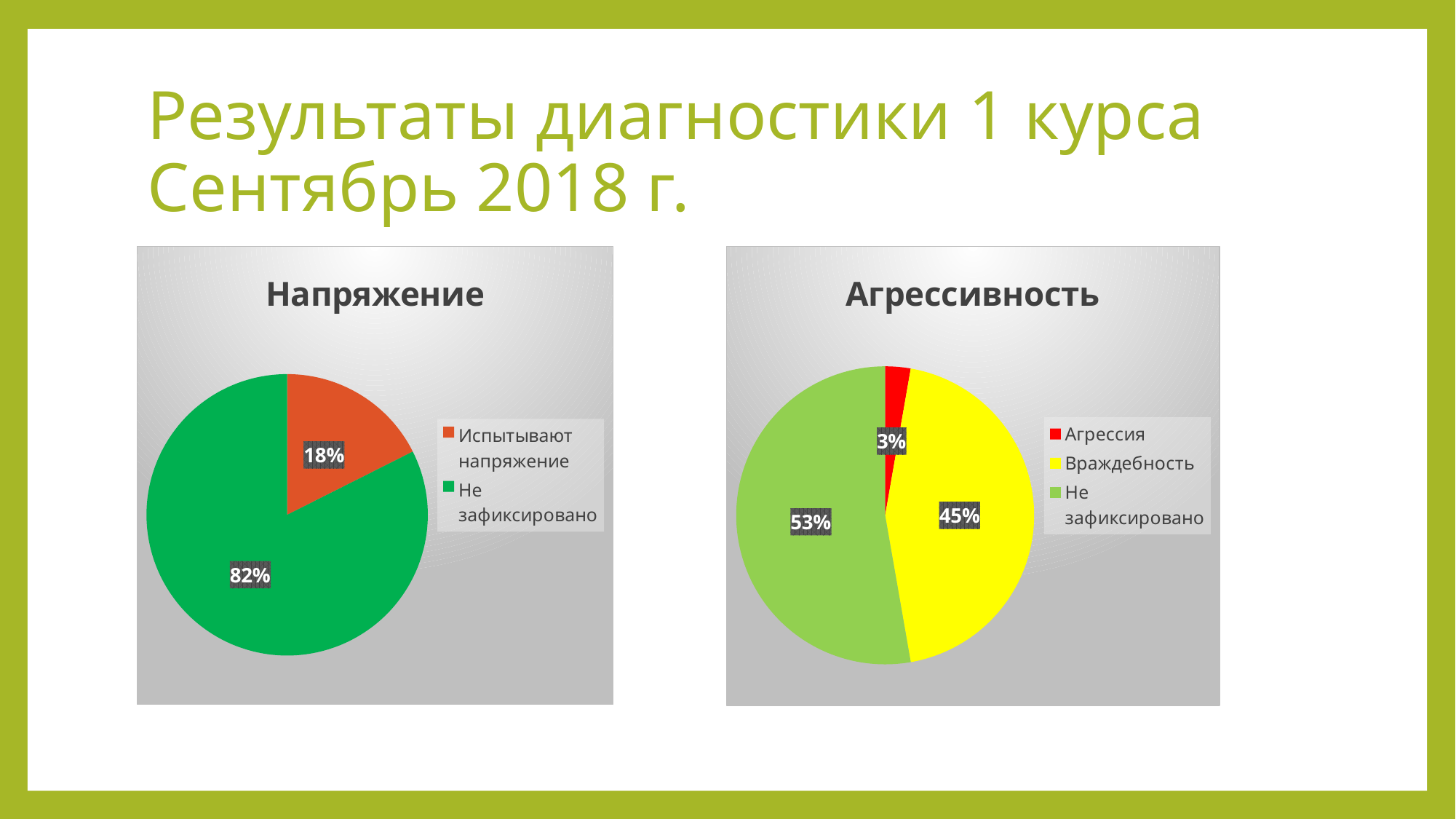
In the "Агрессивность" chart, which category has the smallest slice? Агрессия In the "Агрессивность" chart, which category has the largest slice? Не зафиксировано In the "Агрессивность" chart, what is the value for "Не зафиксировано"? 53% In the "Агрессивность" chart, what is the difference between "Не зафиксировано" and "Враждебность"? 8% What type of chart is the "Напряжение" chart? Pie chart In the "Напряжение" chart, what is the difference between "Не зафиксировано" and "Испытывают напряжение"? 64% In the "Агрессивность" chart, what is the value for "Агрессия"? 3% How many categories does the legend of the "Агрессивность" chart list? 3 In the "Агрессивность" chart, what is the value for "Враждебность"? 45% In the "Агрессивность" chart, which is larger: "Враждебность" or "Агрессия"? Враждебность In the "Напряжение" chart, what share of the pie is labelled "Не зафиксировано"? 82% In the "Напряжение" chart, what share of the pie is labelled "Испытывают напряжение"? 18%